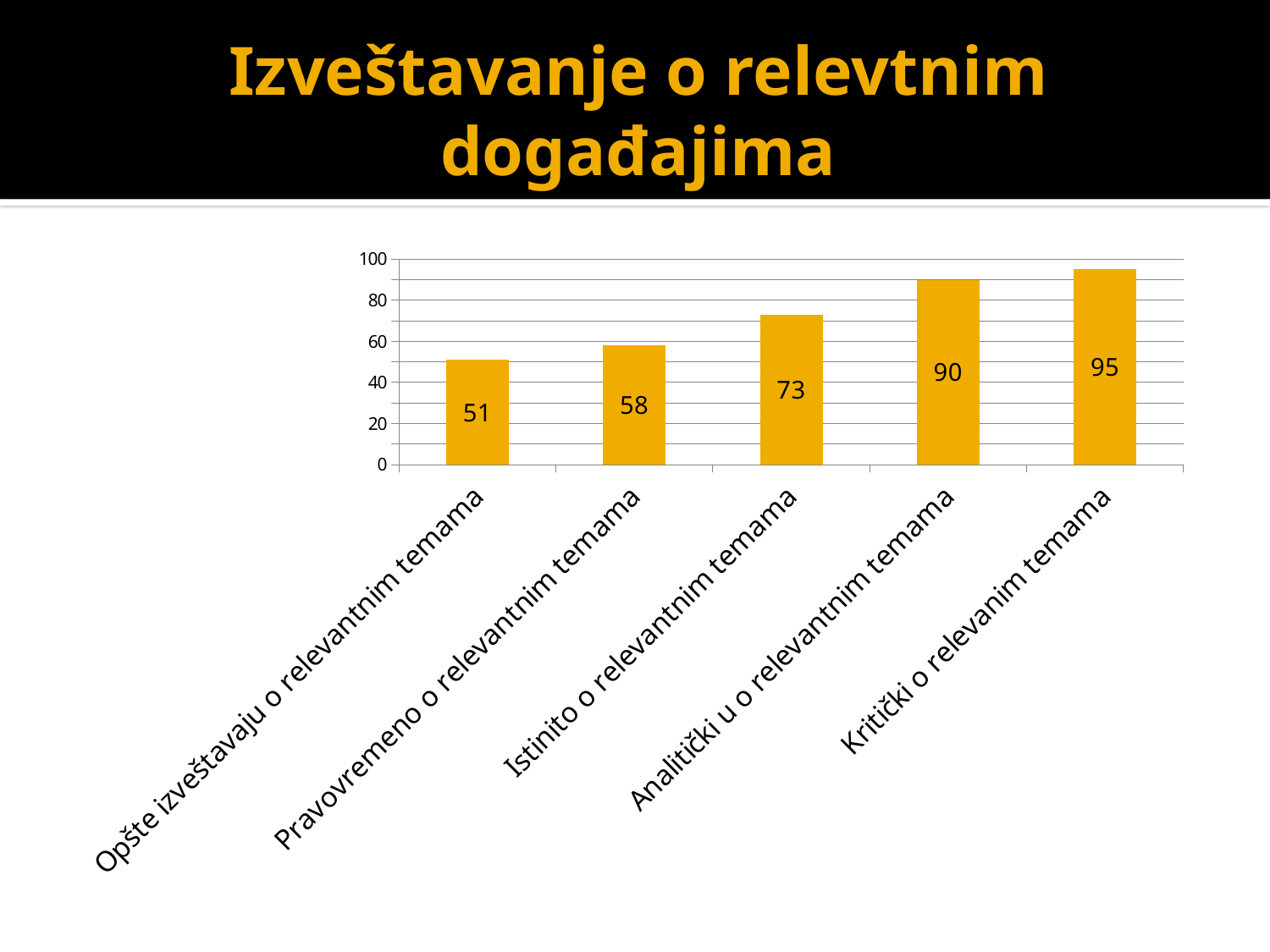
Which category has the highest value? Kritički o relevanim temama Is the value for "Analitički u o relevantnim temama" greater or less than 80? greater What is the title of the slide? Izveštavanje o relevtnim događajima What is the value for "Kritički o relevanim temama"? 95 What kind of chart is shown on the slide? bar chart What is the value for "Opšte izveštavaju o relevantnim temama"? 51 Which is larger, the value for "Istinito o relevantnim temama" or the value for "Pravovremeno o relevantnim temama"? Istinito o relevantnim temama How many categories are shown on the chart? 5 Which category has the lowest value? Opšte izveštavaju o relevantnim temama What is the value for "Istinito o relevantnim temama"? 73 What is the difference between the values for "Analitički u o relevantnim temama" and "Pravovremeno o relevantnim temama"? 32 Do the values rise or fall from left to right along the x axis? rise